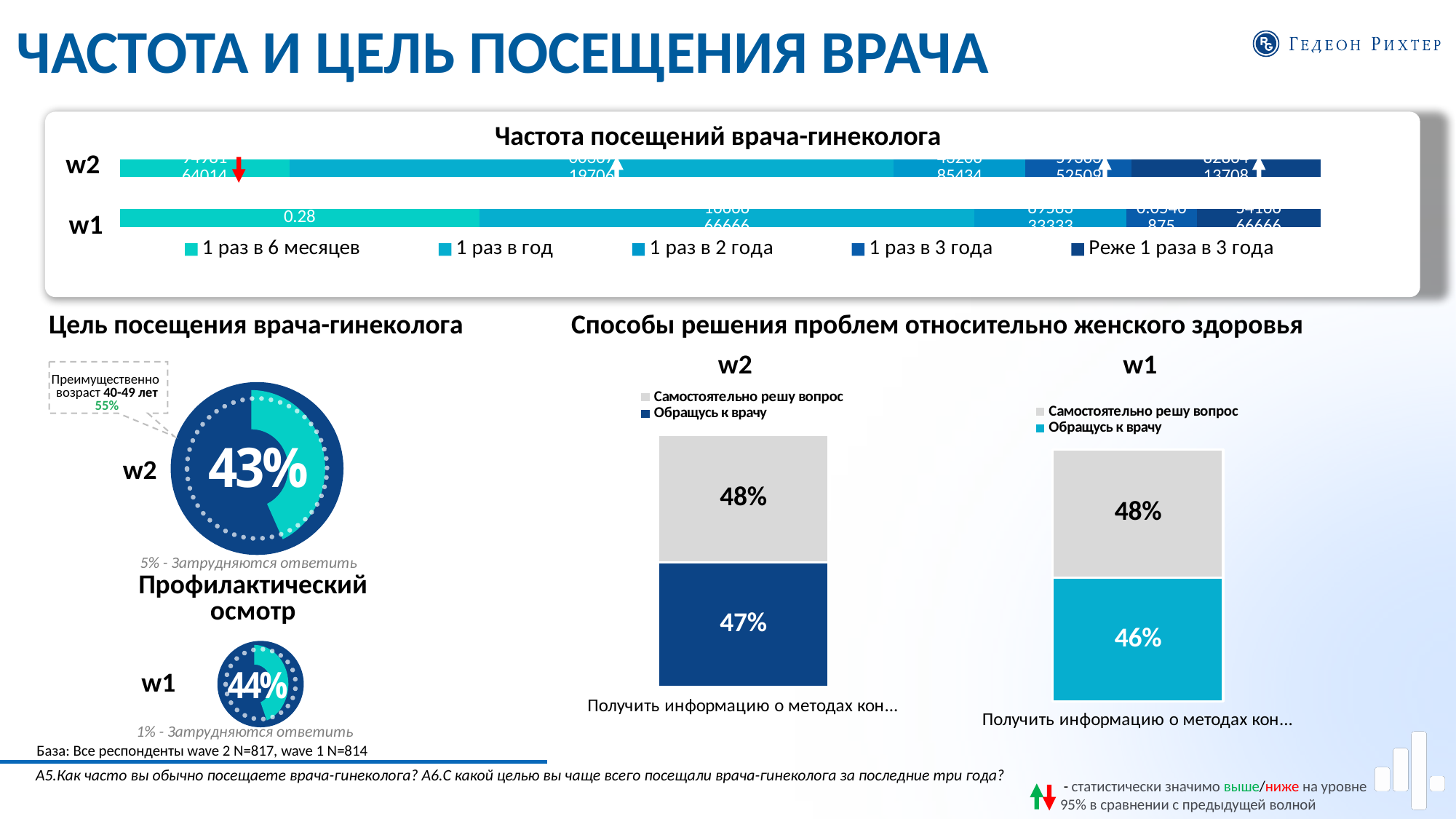
In the chart 'Цель посещения врача-гинеколога', which wave has the higher share for 'Профилактический осмотр': w1 or w2? w1 In the chart 'Способы решения проблем относительно женского здоровья', which is larger in w2: 'Самостоятельно решу вопрос' or 'Обращусь к врачу'? Самостоятельно решу вопрос In the chart 'Способы решения проблем относительно женского здоровья', what is the difference between 'Самостоятельно решу вопрос' and 'Обращусь к врачу' in w1? 2% In the chart 'Способы решения проблем относительно женского здоровья', what is the value for 'Обращусь к врачу' in w2? 47% In the chart 'Цель посещения врача-гинеколога', what share is shown for 'Профилактический осмотр' in w2? 43% In the chart 'Способы решения проблем относительно женского здоровья', what is the total of the w2 stacked bar? 95% How many series does the legend of the chart 'Частота посещений врача-гинеколога' list? 5 What kind of chart is 'Частота посещений врача-гинеколога'? Stacked bar chart In the chart 'Способы решения проблем относительно женского здоровья', what is the value for 'Самостоятельно решу вопрос' in w1? 48% In the chart 'Способы решения проблем относительно женского здоровья', what is the value for 'Обращусь к врачу' in w1? 46% How many bars (waves) are shown in the chart 'Частота посещений врача-гинеколога'? 2 In the chart 'Цель посещения врача-гинеколога', what share is shown for 'Профилактический осмотр' in w1? 44%